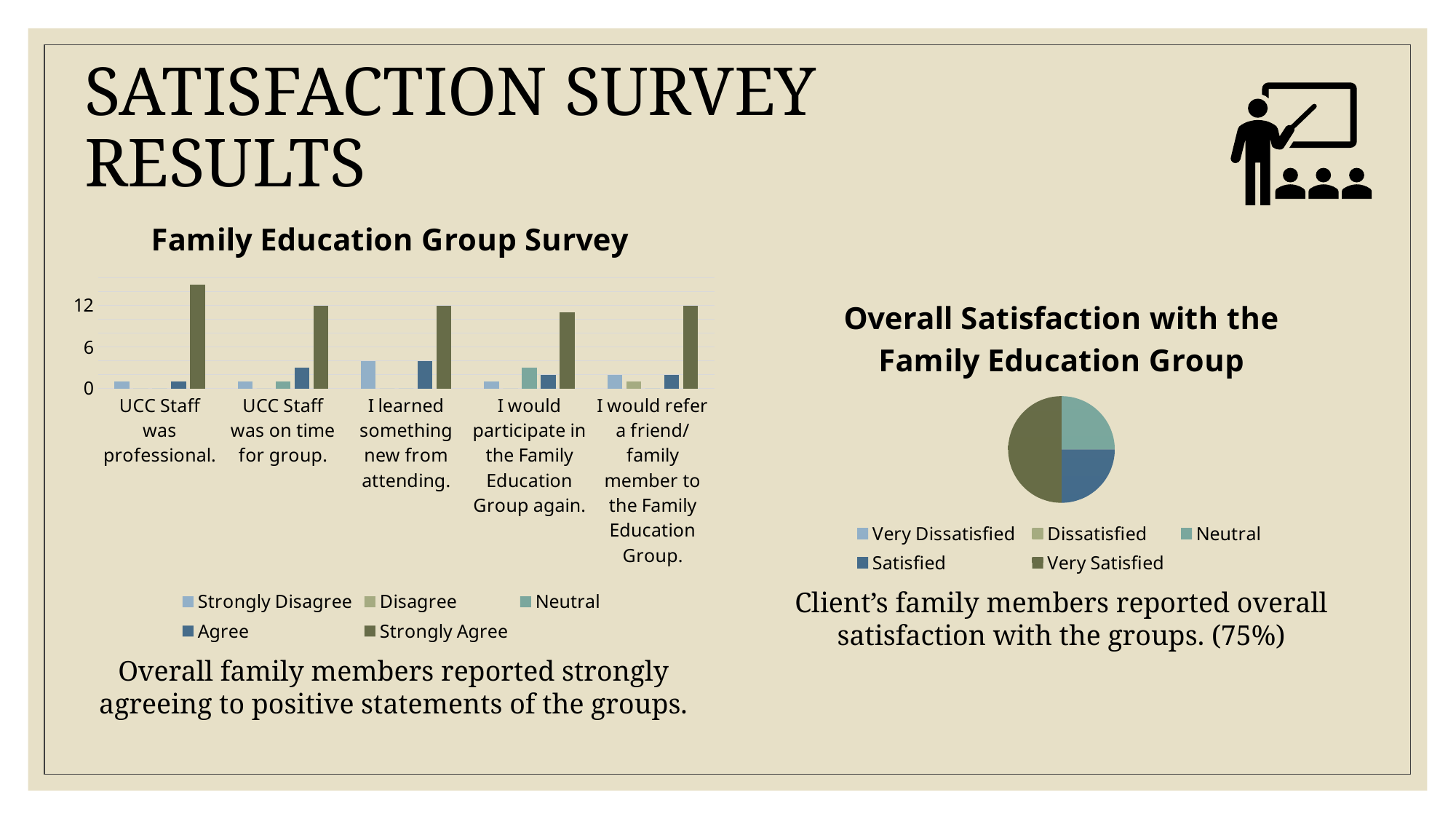
What kind of chart is the 'Family Education Group Survey' chart on the left? Bar chart In the 'Family Education Group Survey' chart, is the 'Agree' value for 'I learned something new from attending.' greater or less than 6? less What is the title of the pie chart on the right of the slide? Overall Satisfaction with the Family Education Group In the 'Overall Satisfaction with the Family Education Group' pie chart, which category has the largest slice? Very Satisfied What is the title of the bar chart on the left of the slide? Family Education Group Survey In the 'Family Education Group Survey' chart, how many survey statements (categories) are shown on the x axis? 5 In the 'Overall Satisfaction with the Family Education Group' pie chart, how many entries does the legend list? 5 What kind of chart is the 'Overall Satisfaction with the Family Education Group' chart on the right? Pie chart In the 'Family Education Group Survey' chart, is the 'Strongly Agree' value for 'UCC Staff was professional.' greater or less than 12? greater In the 'Family Education Group Survey' chart, for 'UCC Staff was professional.', which is larger: the 'Strongly Agree' bar or the 'Agree' bar? Strongly Agree In the 'Family Education Group Survey' chart, which statement has the tallest 'Strongly Agree' bar? UCC Staff was professional. In the 'Family Education Group Survey' chart, how many series does the legend list? 5